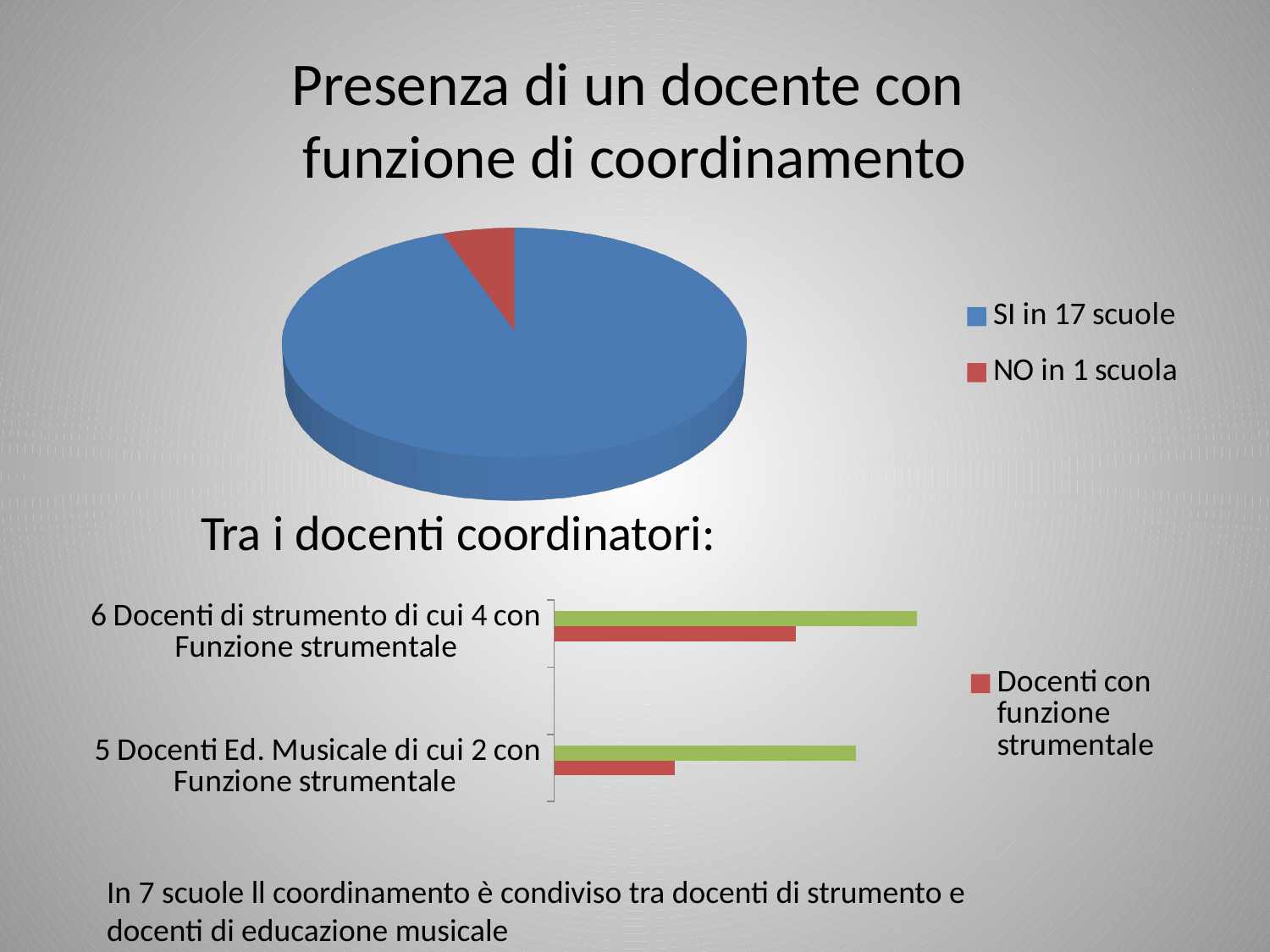
In the top pie chart, which slice is the smallest? NO in 1 scuola What kind of chart is the bottom chart on the slide (under 'Tra i docenti coordinatori:')? bar chart What kind of chart is the top chart on the slide? pie chart In the top pie chart, how many schools are in the 'NO' category? 1 In the bottom bar chart, which category has the longer red 'Docenti con funzione strumentale' bar? 6 Docenti di strumento di cui 4 con Funzione strumentale In the top pie chart, which slice is the largest? SI in 17 scuole In the top pie chart, what colour is the 'SI in 17 scuole' slice? blue In the top pie chart, how many slices are there? 2 In the top pie chart, how many schools are in the 'SI' category? 17 In the top pie chart, what is the difference between the number of 'SI' schools and 'NO' schools? 16 In the bottom bar chart, how many 'Docenti di strumento' have a Funzione strumentale according to the category label? 4 In the bottom bar chart, how many categories are shown on the vertical axis? 2